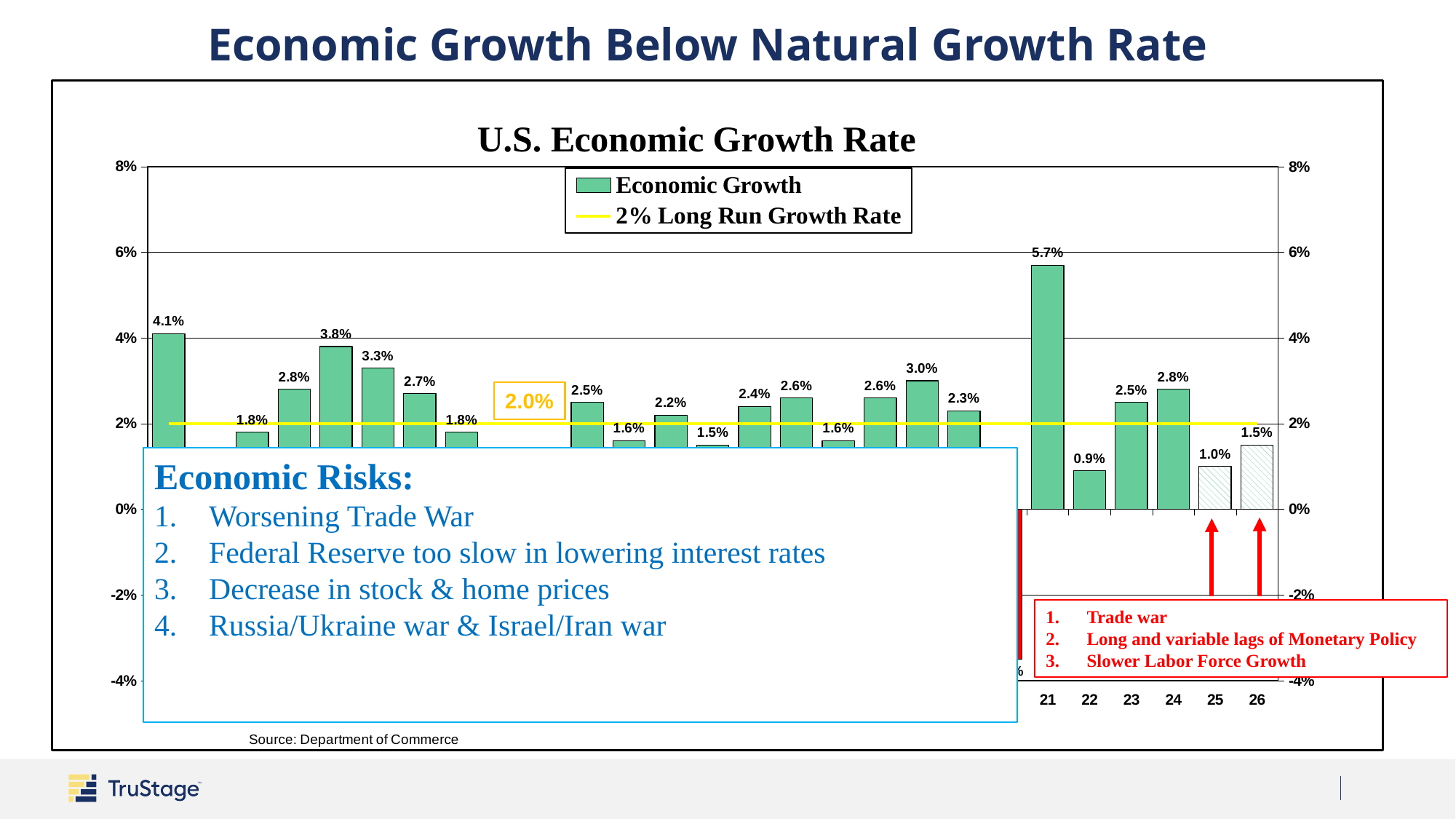
Which year has the highest economic growth rate on the chart? 21 What kind of chart is used to show Economic Growth? bar chart What is the economic growth rate shown for 24? 2.8% How many series does the chart legend list? 2 What is the economic growth rate shown for 22? 0.9% What is the economic growth rate shown for 21? 5.7% Is the economic growth rate for 23 greater or less than the one for 25? greater What is the difference between the economic growth rate for 21 and for 22? 4.8% Which year among 21 to 26 has the lowest economic growth rate? 22 What long run growth rate does the yellow line represent? 2% What is the title of the chart? U.S. Economic Growth Rate What is the economic growth rate shown for 26? 1.5%